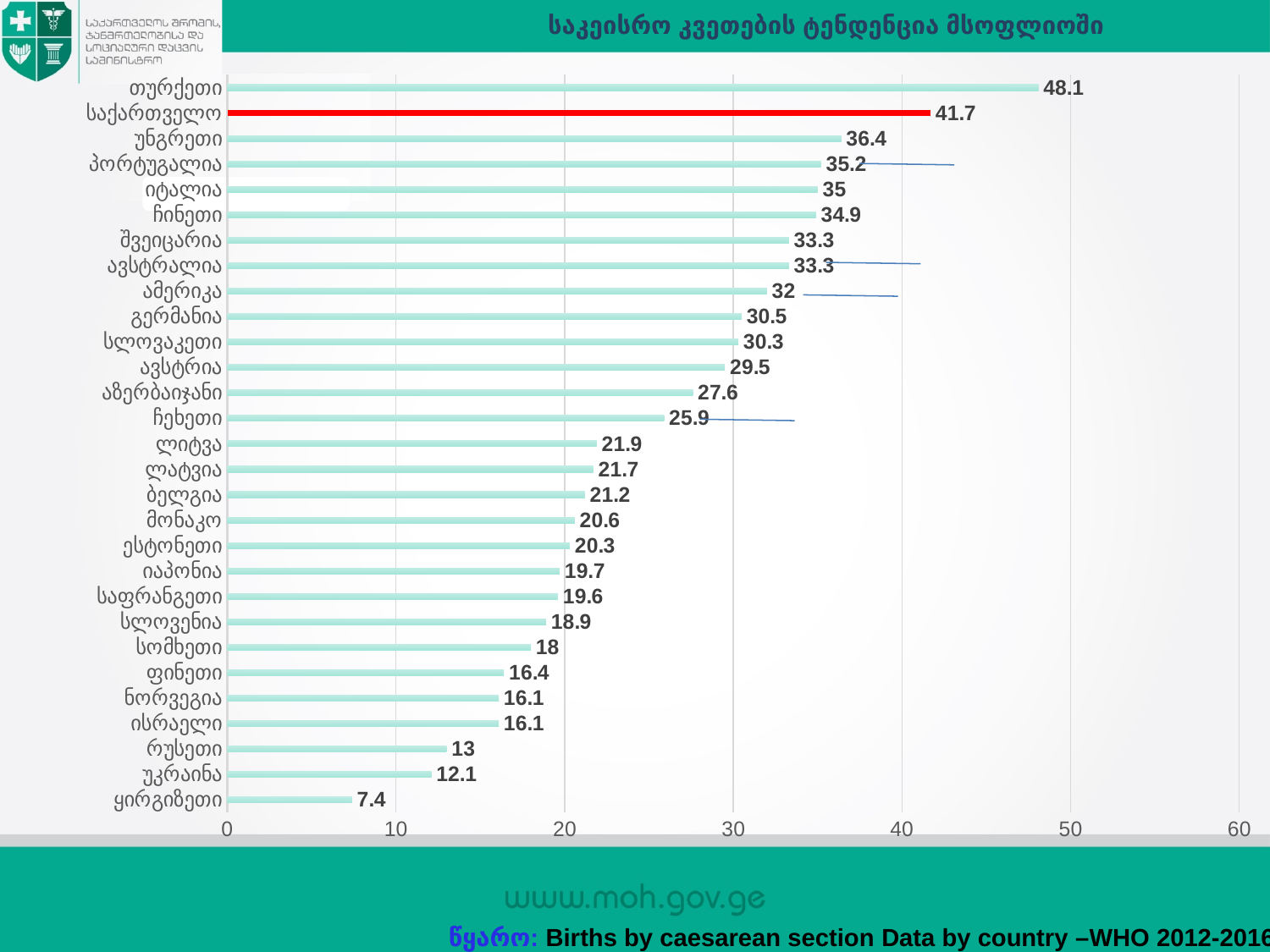
What is the value for აზერბაიჯანი? 27.6 Which bar is highlighted in red? საქართველო What is the value for საქართველო? 41.7 Which country has the lowest value? ყირგიზეთი What is the value for ყირგიზეთი? 7.4 Is the value for ჩეხეთი greater or less than 30? less What is the value for თურქეთი? 48.1 Which country has the highest value? თურქეთი How many countries are shown in the chart? 29 Which has a larger value, უნგრეთი or გერმანია? უნგრეთი What is the difference between the values for თურქეთი and საქართველო? 6.4 What kind of chart is shown on the slide? bar chart